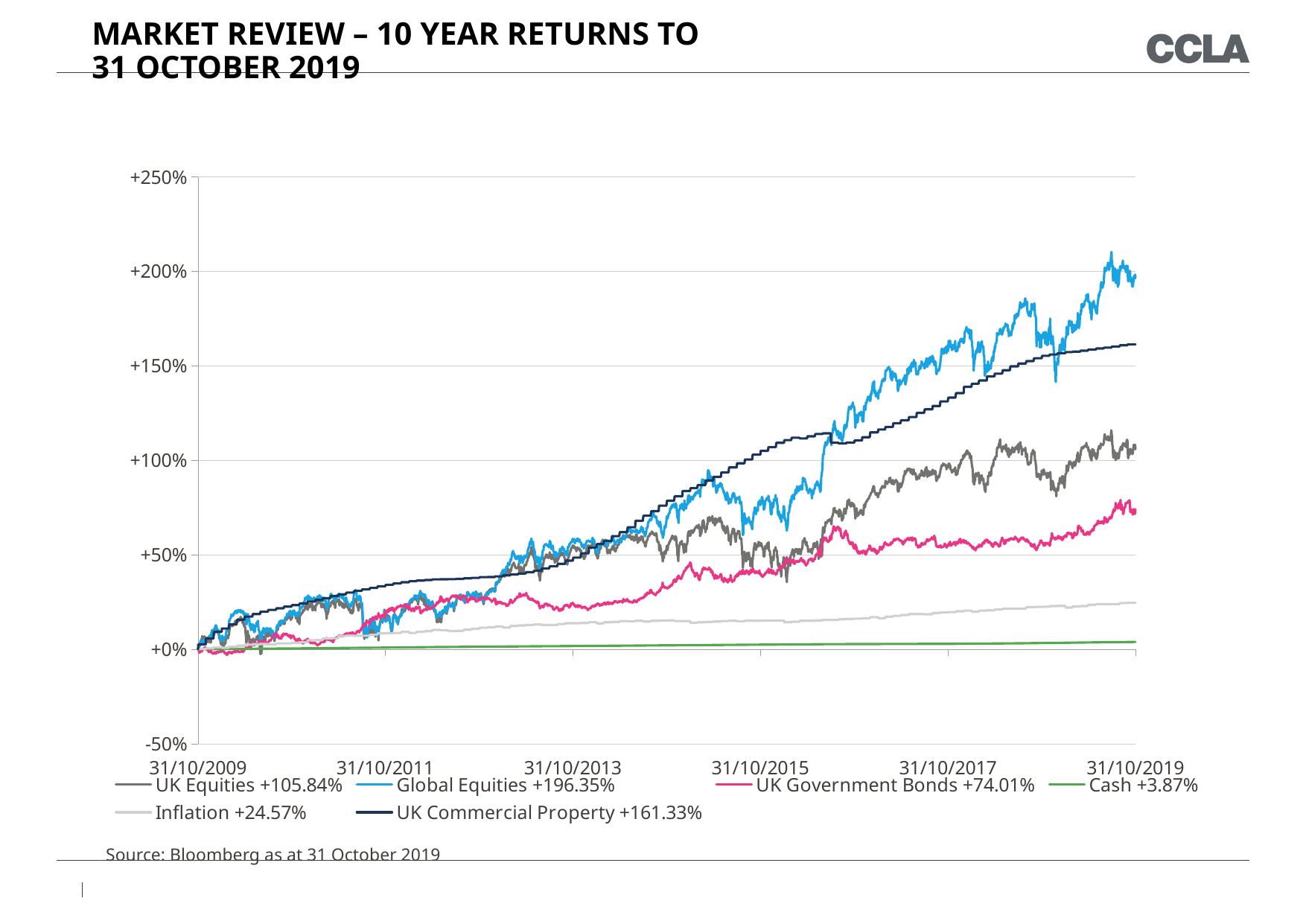
What kind of chart is shown on the slide? Line chart What is the 10 year return for Inflation shown in the legend? +24.57% Which series has the lowest 10 year return? Cash What is the 10 year return for Global Equities shown in the legend? +196.35% What is the 10 year return for Cash shown in the legend? +3.87% Does the Inflation line rise or fall from 31/10/2009 to 31/10/2019? Rises What is the difference between the 10 year returns of Global Equities and UK Commercial Property? 35.02 percentage points Which has the larger 10 year return, UK Equities or UK Government Bonds? UK Equities Is the value for UK Equities at 31/10/2017 greater or less than +50%? greater How many series does the legend list? 6 What is the 10 year return for UK Commercial Property shown in the legend? +161.33% Which series has the highest 10 year return? Global Equities